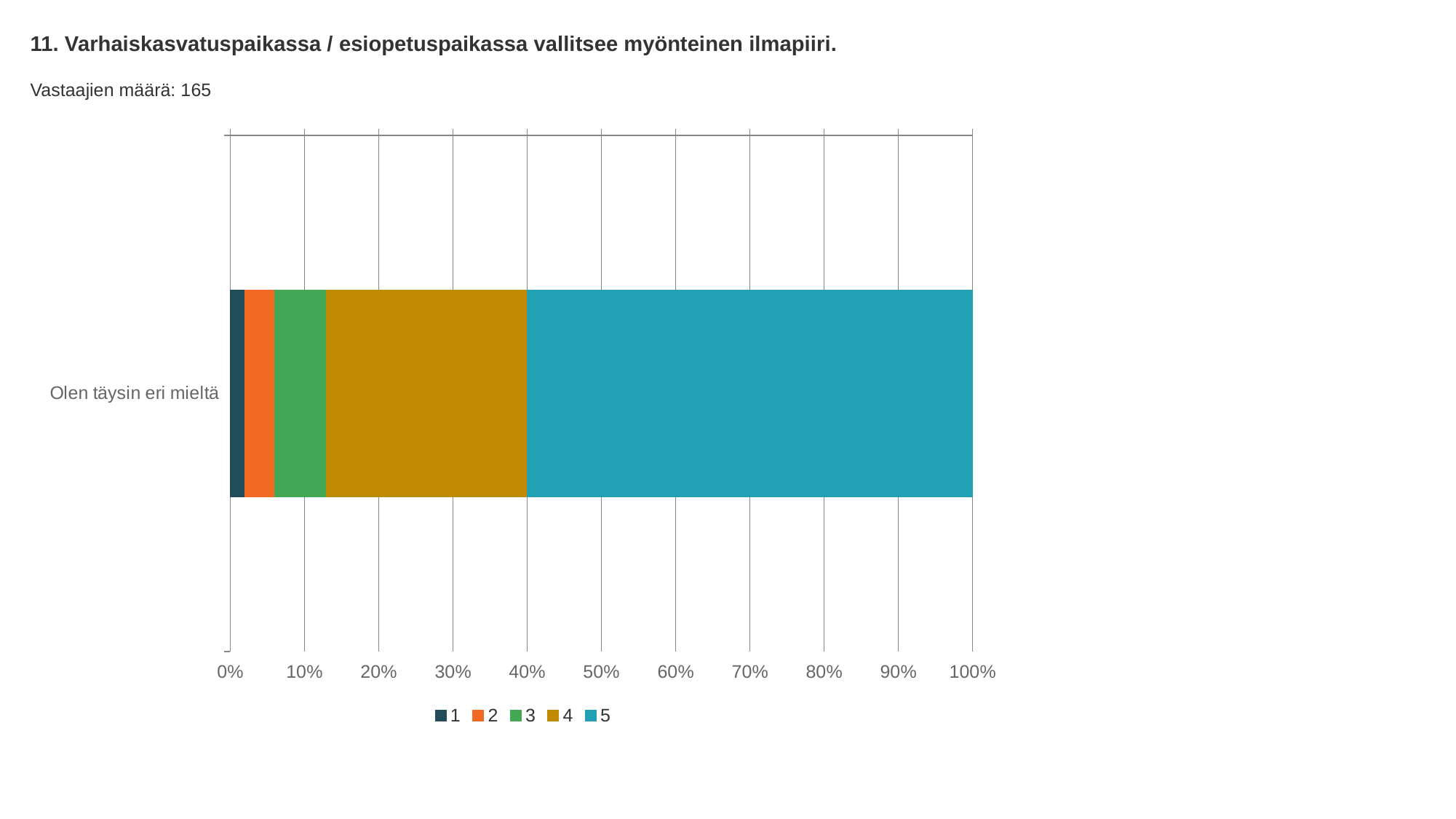
What is the category label shown on the y axis? Olen täysin eri mieltä How many categories are plotted on the y axis? 1 What kind of chart is shown on the slide? Stacked bar chart Is the value for series 5 greater or less than 50%? greater Which series has the smallest segment in the bar? 1 Which series has a larger segment, 4 or 3? 4 Is the value for series 3 greater or less than 10%? less How many series does the legend list? 5 Which series has a larger segment, 2 or 5? 5 What is the number of respondents (Vastaajien määrä) stated on the slide? 165 Which series has the largest segment in the bar? 5 Is the value for series 4 greater or less than 20%? greater